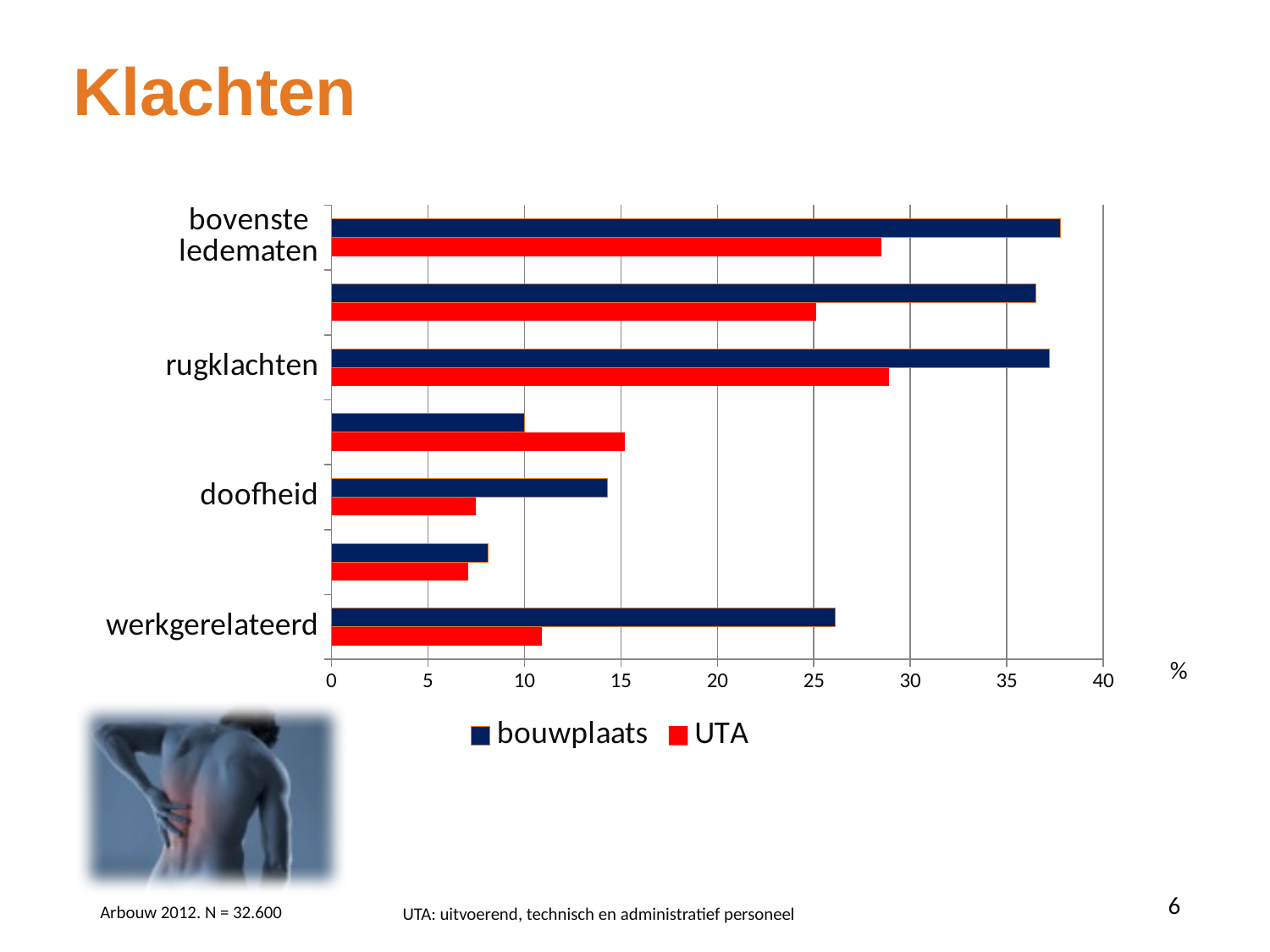
Is the UTA value for werkgerelateerd greater or less than 15? less Is the UTA value for bovenste ledematen greater or less than 30? less For doofheid, which series has the larger value, bouwplaats or UTA? bouwplaats What unit is shown at the end of the horizontal axis? % Is the UTA value for rugklachten greater or less than 25? greater For werkgerelateerd, which series has the larger value, bouwplaats or UTA? bouwplaats What kind of chart is shown on the slide? bar chart How many pairs of bars (categories) are plotted in the chart? 7 How many series does the legend list? 2 Which two series are listed in the legend? bouwplaats and UTA